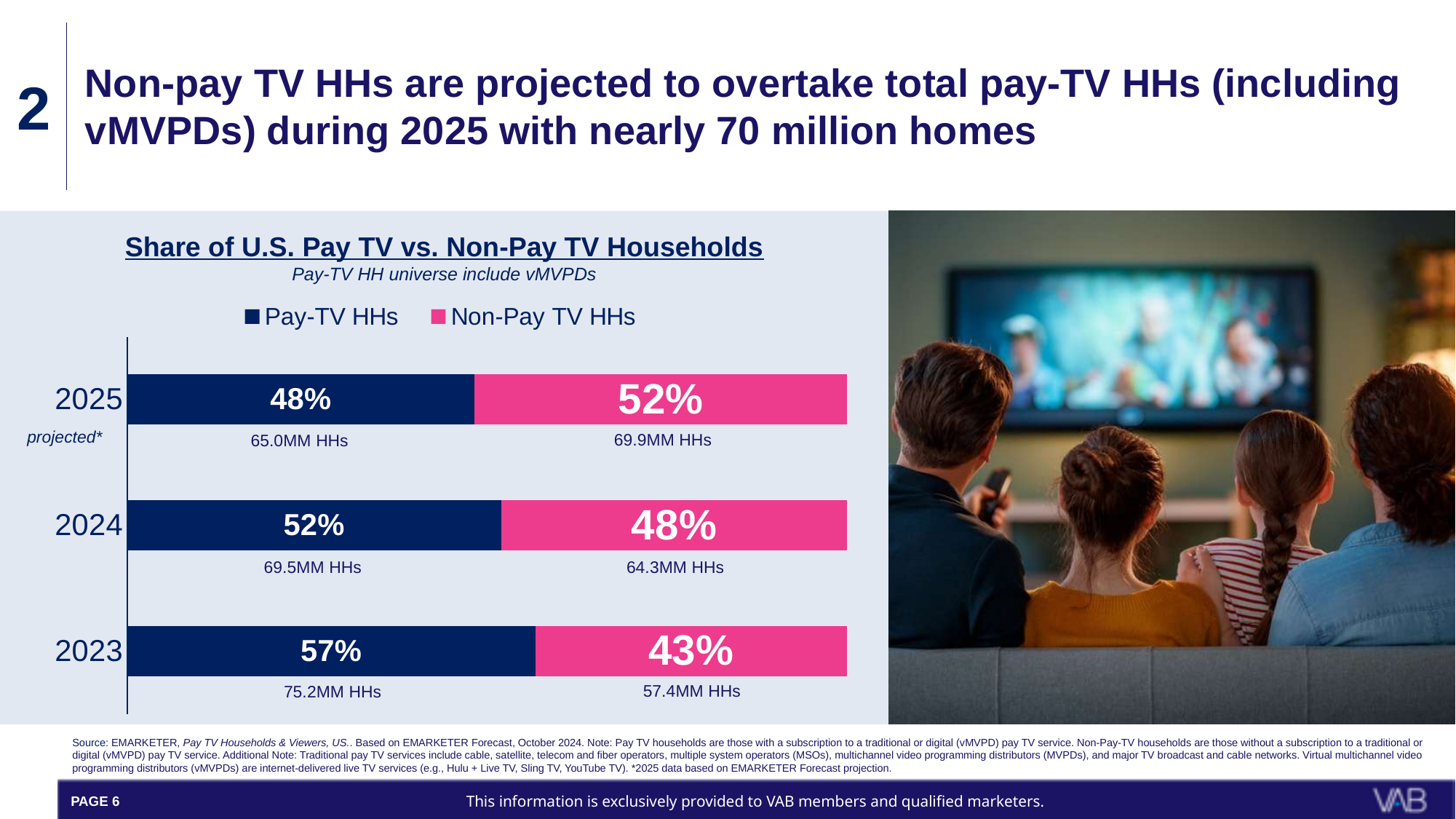
How many households (in MM) are Pay-TV HHs in 2023? 75.2MM HHs What is the Non-Pay TV HHs share for 2024? 48% How many series does the legend list? 2 What is the Non-Pay TV HHs share for 2025? 52% Which is larger in 2025, the Pay-TV HHs share or the Non-Pay TV HHs share? Non-Pay TV HHs In which year is the Non-Pay TV HHs share lowest? 2023 What kind of chart is shown on the slide? Stacked bar chart In which year is the Pay-TV HHs share highest? 2023 How many years are shown on the chart? 3 What is the difference in percentage points between the Pay-TV HHs share in 2023 and in 2025? 9 percentage points What is the Pay-TV HHs share for 2023? 57% How many households (in MM) are Non-Pay TV HHs in 2025? 69.9MM HHs